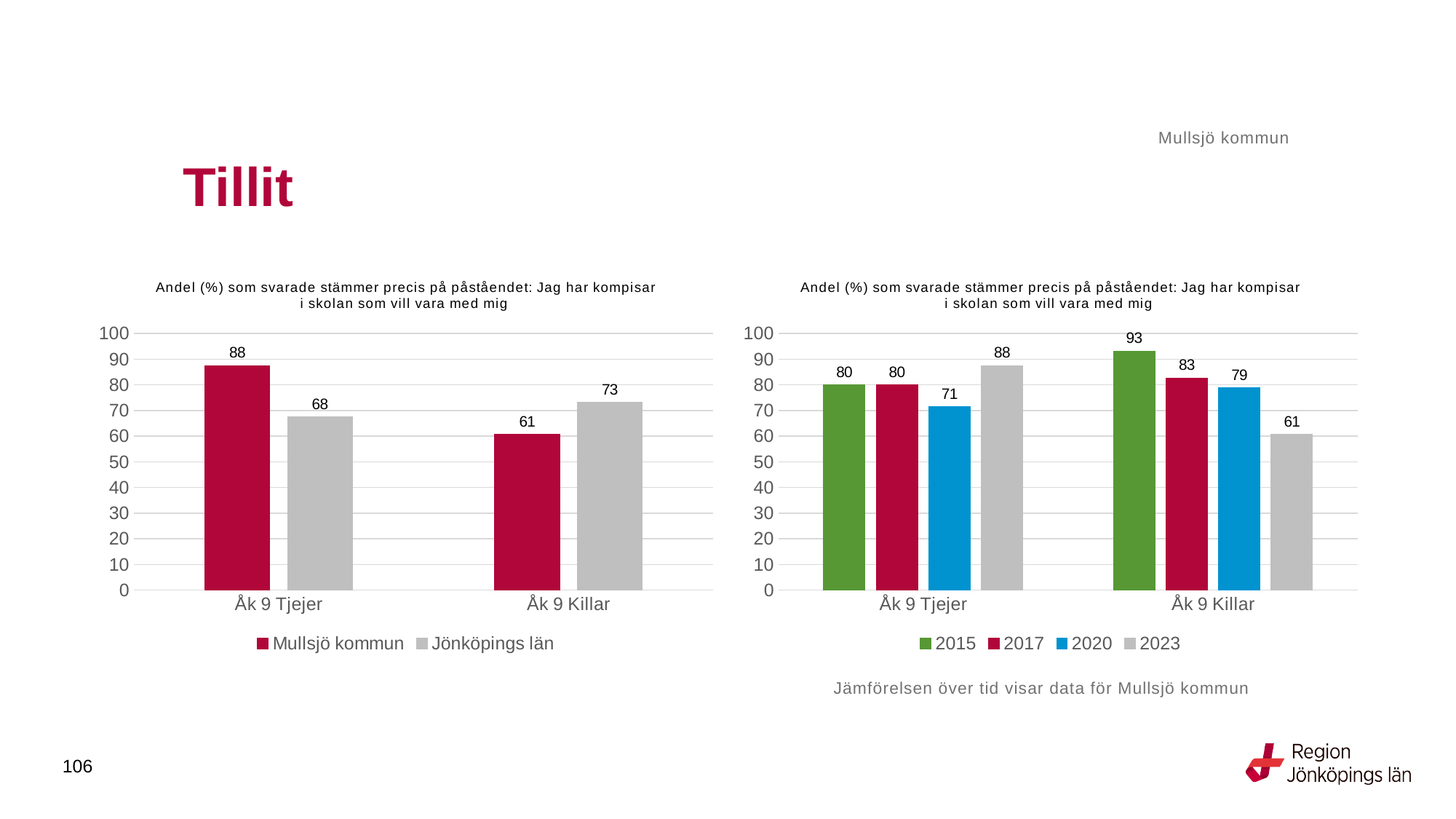
In the right chart, which year has the highest value for Åk 9 Killar? 2015 In the left chart, what is the value for Jönköpings län for Åk 9 Killar? 73 In the left chart, how many series does the legend list? 2 In the left chart, which is larger for Åk 9 Killar: Mullsjö kommun or Jönköpings län? Jönköpings län What kind of chart is the left chart? Bar chart In the left chart, what is the difference between Mullsjö kommun and Jönköpings län for Åk 9 Tjejer? 20 In the left chart, what is the value for Mullsjö kommun for Åk 9 Tjejer? 88 In the right chart, how many series does the legend list? 4 In the right chart, what is the value for 2020 for Åk 9 Tjejer? 71 In the right chart, which year has the lowest value for Åk 9 Tjejer? 2020 In the right chart, what is the value for 2015 for Åk 9 Killar? 93 In the right chart, what is the difference between the 2015 and 2023 values for Åk 9 Killar? 32